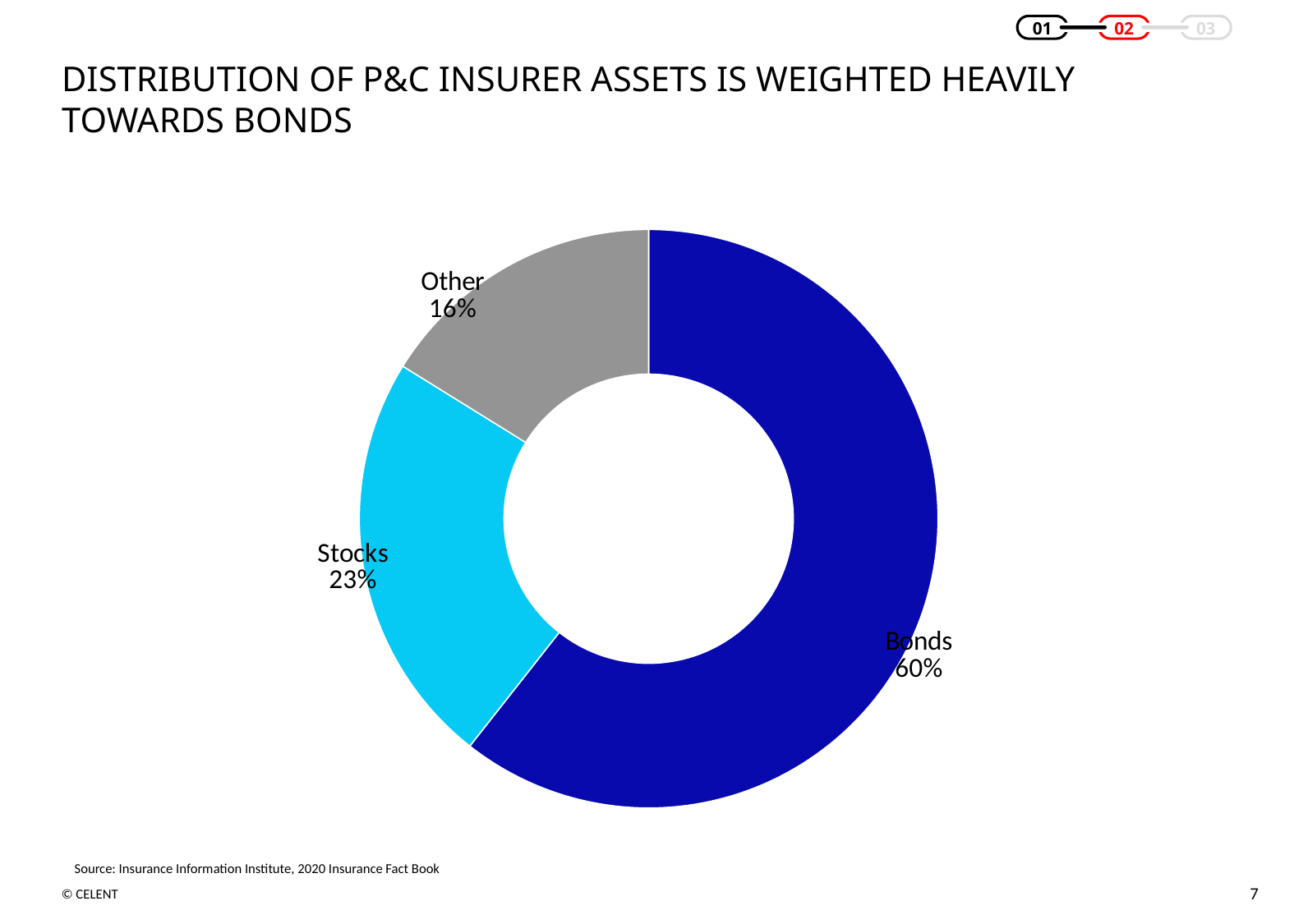
What source is cited for the chart data? Insurance Information Institute, 2020 Insurance Fact Book Which asset category has the largest share? Bonds What colour is the Stocks segment? Light blue (cyan) What is the difference in percentage points between the Bonds share and the Stocks share? 37 percentage points Which asset category has the smallest share? Other What share of P&C insurer assets is in Stocks? 23% What share of P&C insurer assets is in Bonds? 60% What kind of chart is shown on the slide? Doughnut (pie) chart How many asset categories are shown in the chart? 3 What share of P&C insurer assets is in Other? 16% Which is larger, the share for Stocks or the share for Other? Stocks What is the difference in percentage points between the Stocks share and the Other share? 7 percentage points